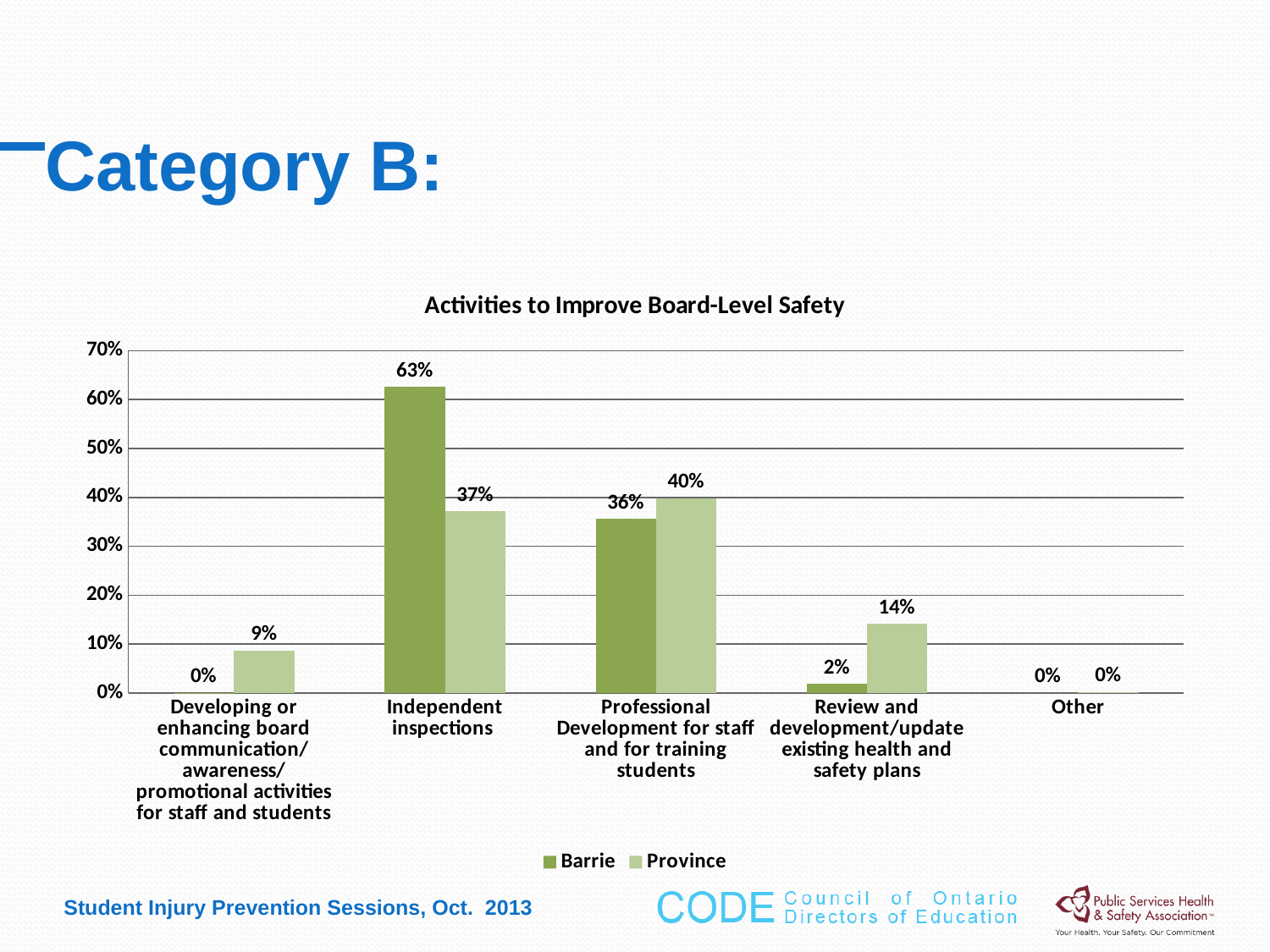
Is the Barrie value for Independent inspections greater or less than 60%? greater Which category has the lowest Province value? Other What kind of chart is shown on the slide? Bar chart What is the Barrie value for Independent inspections? 63% What is the Province value for Review and development/update existing health and safety plans? 14% What is the title of the chart? Activities to Improve Board-Level Safety What is the difference between the Barrie and Province values for Independent inspections? 26% Which category has the highest Barrie value? Independent inspections How many categories are shown on the x axis? 5 For Professional Development for staff and for training students, which series has the larger value, Barrie or Province? Province How many series does the legend list? 2 What is the Province value for Professional Development for staff and for training students? 40%